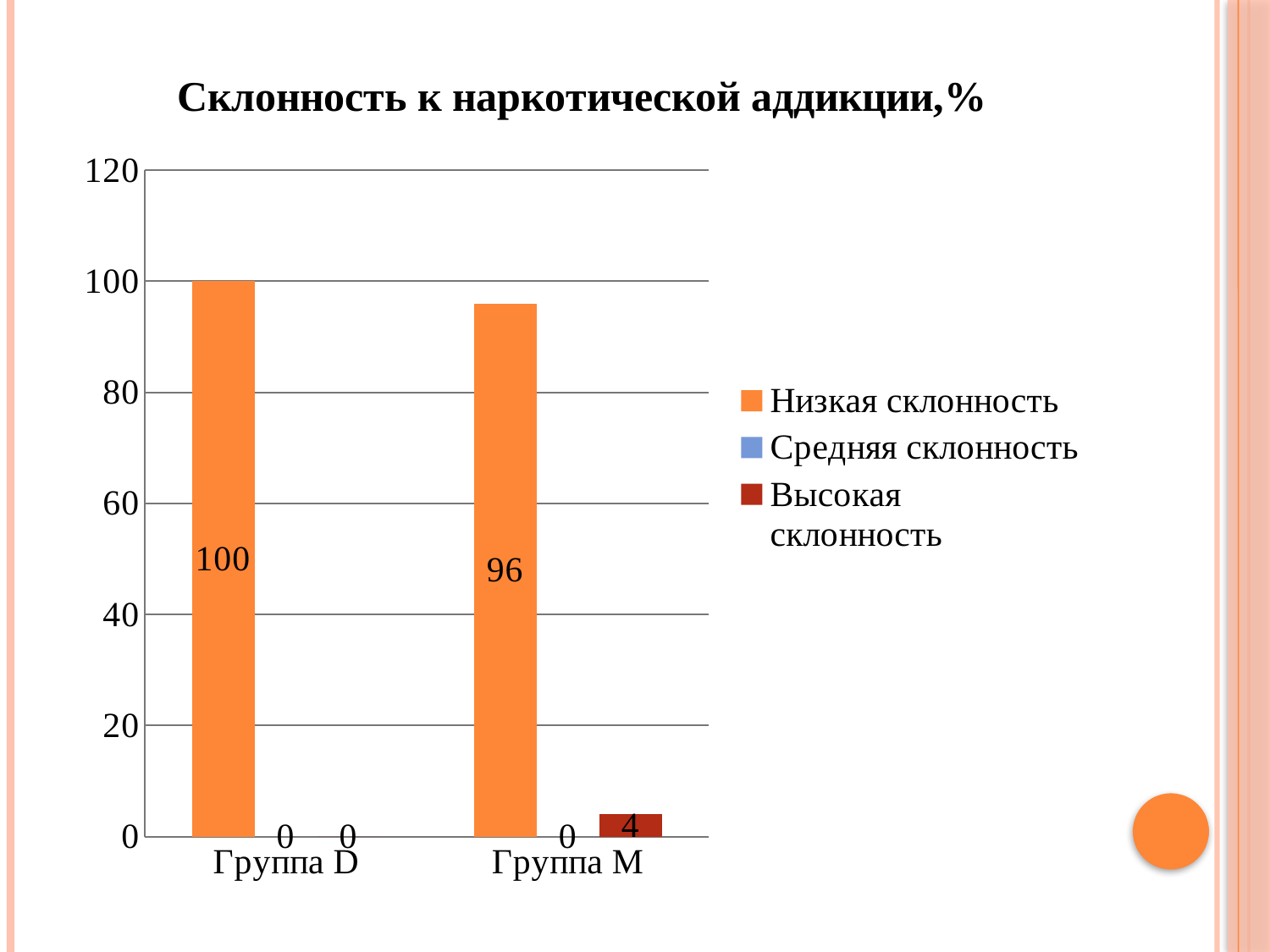
What is the value of Низкая склонность for Группа М? 96 What is the value of Низкая склонность for Группа D? 100 What kind of chart is shown on the slide? Bar chart What is the difference between Низкая склонность and Высокая склонность for Группа М? 92 What is the value of Высокая склонность for Группа М? 4 What is the title of the chart? Склонность к наркотической аддикции,% How many series does the legend list? 3 What is the value of Средняя склонность for Группа D? 0 Which group has the higher value for Низкая склонность? Группа D What is the value of Высокая склонность for Группа D? 0 What is the difference between the Низкая склонность values for Группа D and Группа М? 4 How many groups are shown on the x axis? 2